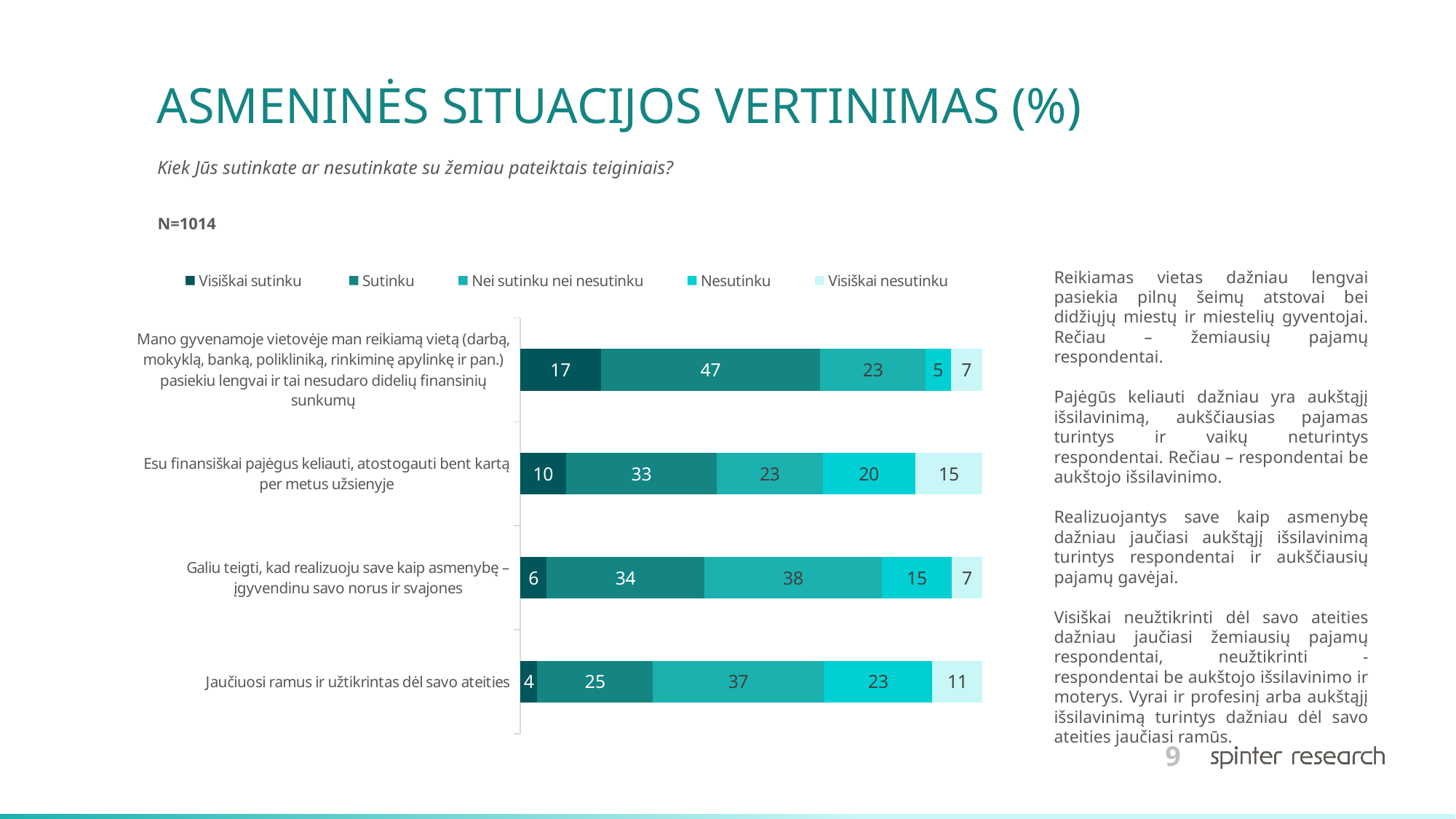
Which statement has the highest 'Visiškai sutinku' value? Mano gyvenamoje vietovėje man reikiamą vietą (darbą, mokyklą, banką, polikliniką, rinkiminę apylinkę ir pan.) pasiekiu lengvai ir tai nesudaro didelių finansinių sunkumų What is the 'Sutinku' value for the statement 'Mano gyvenamoje vietovėje man reikiamą vietą ... pasiekiu lengvai ir tai nesudaro didelių finansinių sunkumų'? 47 What is the 'Nei sutinku nei nesutinku' value for 'Jaučiuosi ramus ir užtikrintas dėl savo ateities'? 37 What is the total of the stacked bar for 'Galiu teigti, kad realizuoju save kaip asmenybę – įgyvendinu savo norus ir svajones'? 100 What is the difference between the 'Nesutinku' values for 'Esu finansiškai pajėgus keliauti, atostogauti bent kartą per metus užsienyje' and 'Galiu teigti, kad realizuoju save kaip asmenybę – įgyvendinu savo norus ir svajones'? 5 How many statements (categories) are plotted in the chart? 4 What type of chart is shown on the slide? stacked bar chart What is the 'Visiškai nesutinku' value for 'Esu finansiškai pajėgus keliauti, atostogauti bent kartą per metus užsienyje'? 15 Which statement has the lowest 'Visiškai sutinku' value? Jaučiuosi ramus ir užtikrintas dėl savo ateities How many series does the legend list? 5 What sample size (N) is stated on the slide? N=1014 Which is larger: the 'Sutinku' value for 'Galiu teigti, kad realizuoju save kaip asmenybę' or the 'Sutinku' value for 'Jaučiuosi ramus ir užtikrintas dėl savo ateities'? Galiu teigti, kad realizuoju save kaip asmenybę – įgyvendinu savo norus ir svajones